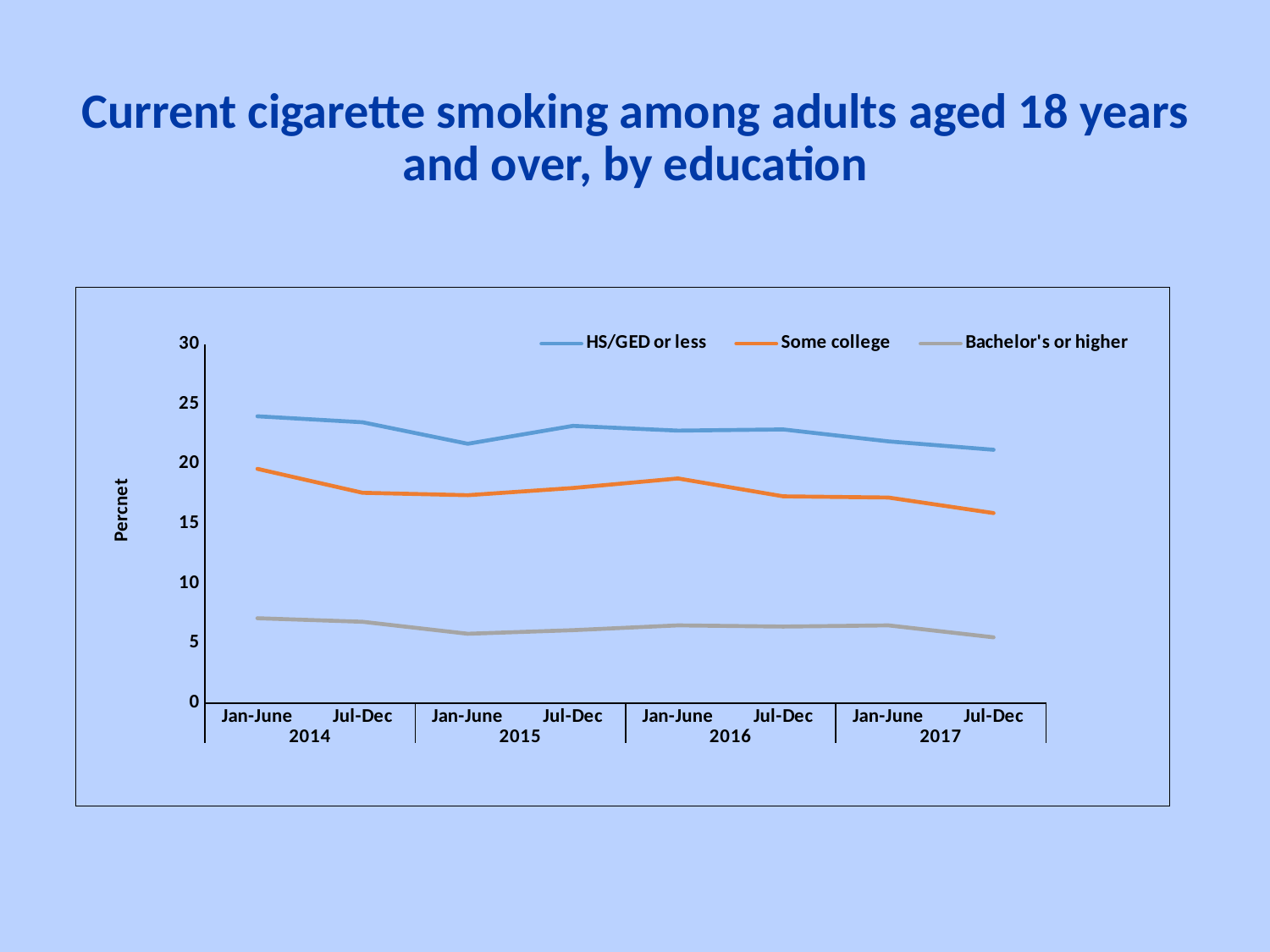
What kind of chart is shown on the slide? line chart Which education group has the highest smoking percentage across the whole period? HS/GED or less Which education group has the lowest smoking percentage across the whole period? Bachelor's or higher Is the value for HS/GED or less in Jan-June 2014 greater or less than 20? greater Is the value for Some college in Jan-June 2016 greater or less than 20? less How many time points are plotted along the x axis? 8 How many series does the legend list? 3 Does the Some college line rise or fall overall from Jan-June 2014 to Jul-Dec 2017? fall Which is larger in Jan-June 2015, the value for Some college or the value for Bachelor's or higher? Some college Is the value for Bachelor's or higher in Jan-June 2014 greater or less than 5? greater What is the label on the y axis? Percnet